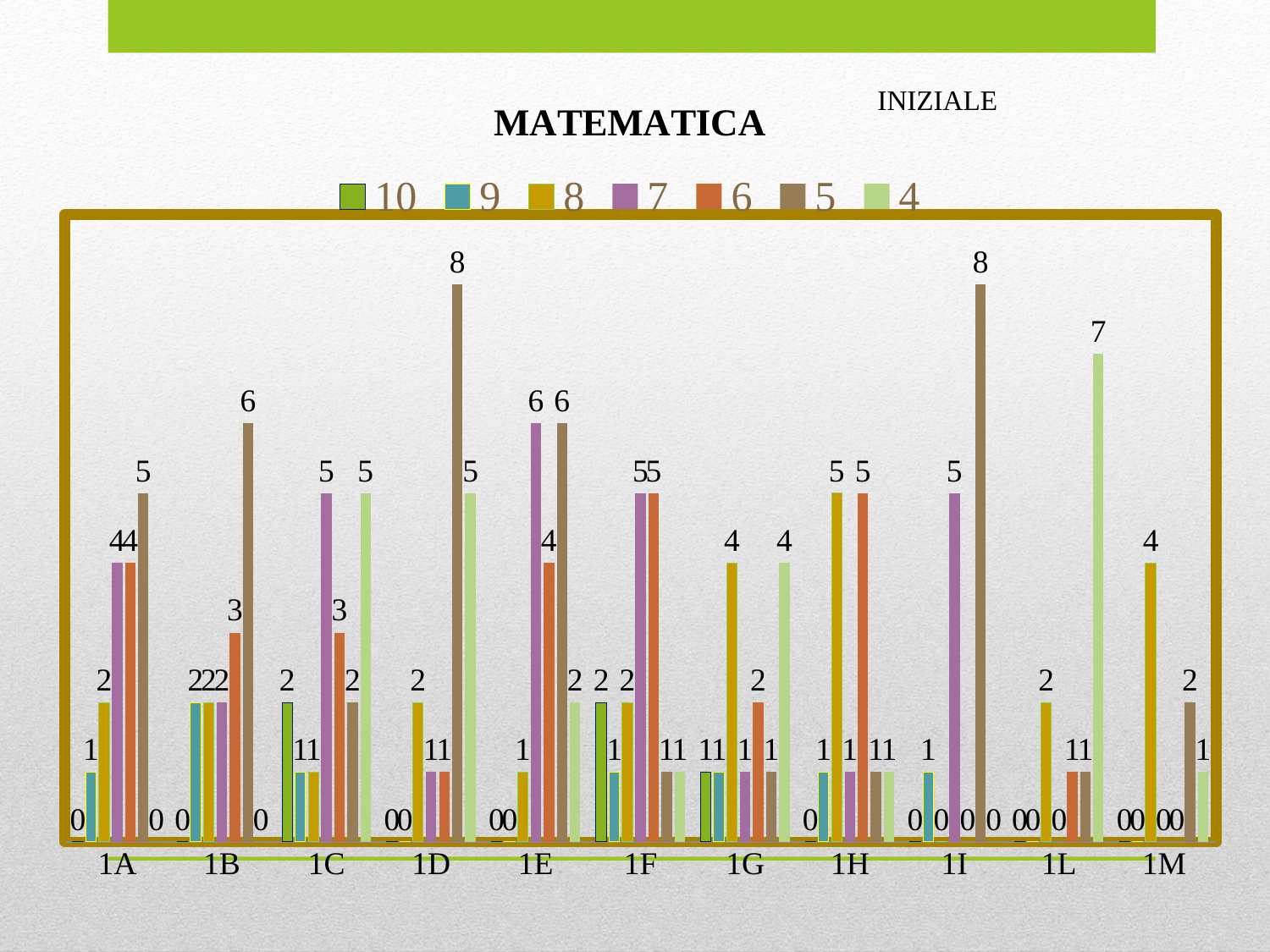
How many series does the legend list? 7 Which class has the highest value for series 7? 1E Which is larger: the series 8 value for 1H or the series 8 value for 1G? 1H What is the difference between the series 5 value for 1B and the series 5 value for 1A? 1 Which class has the highest value for series 4? 1L How many classes (categories) are shown on the x axis? 11 What is the title of the chart? MATEMATICA What is the value of series 8 for class 1M? 4 What is the value of series 7 for class 1I? 5 What is the value of series 4 for class 1L? 7 What kind of chart is shown on the slide? bar chart What is the value of series 5 for class 1D? 8